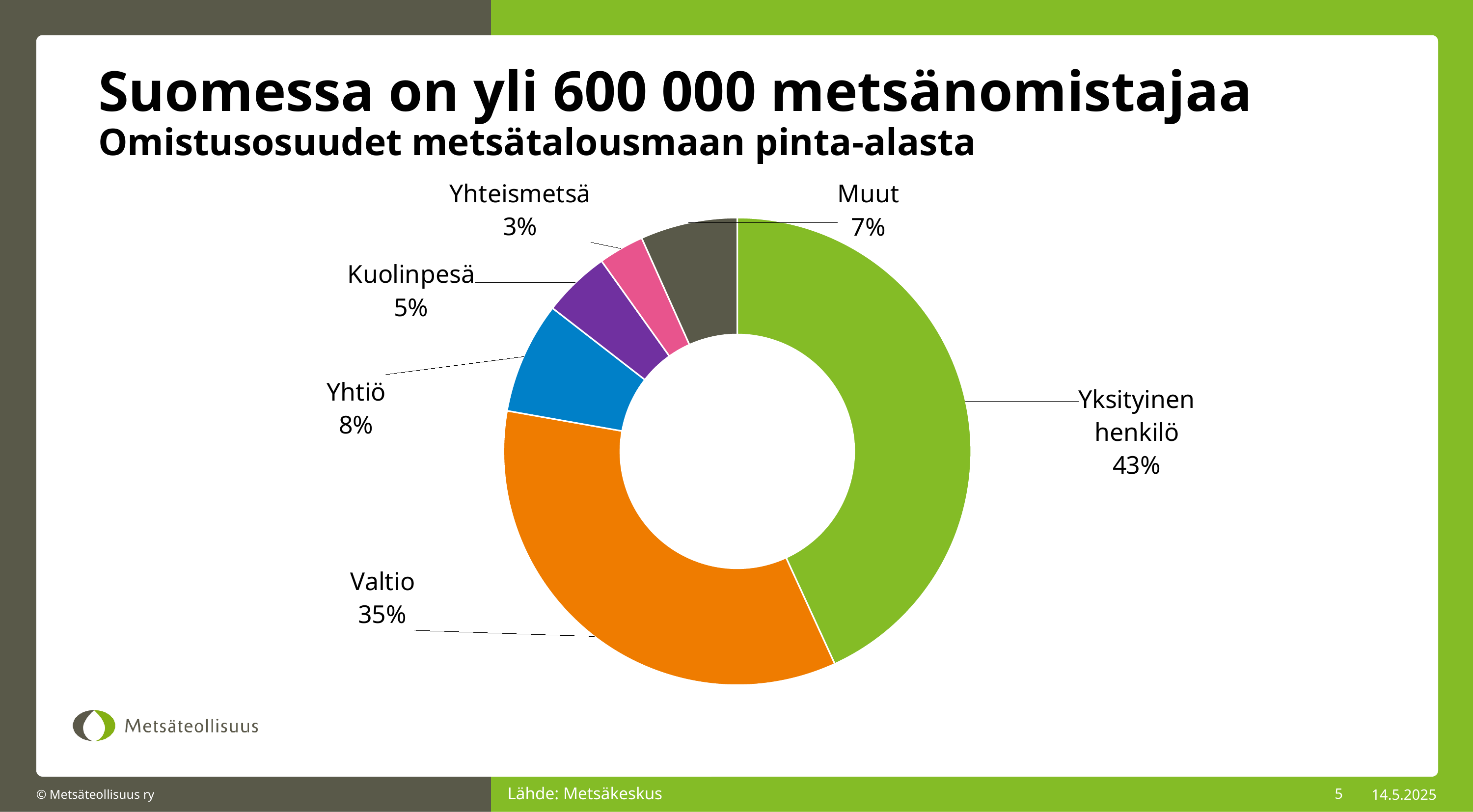
Which has a larger share, Yhtiö or Muut? Yhtiö What share of forestry land is owned by Yksityinen henkilö? 43% Which category has the largest share of forestry land? Yksityinen henkilö What share does Muut hold? 7% How many percentage points larger is the share of Yksityinen henkilö than that of Valtio? 8 What kind of chart is shown on the slide? Pie (doughnut) chart What share does Yhteismetsä hold? 3% What share does Yhtiö hold? 8% What share of forestry land is owned by Valtio? 35% Which category has the smallest share? Yhteismetsä What share does Kuolinpesä hold? 5% How many categories are shown in the chart? 6